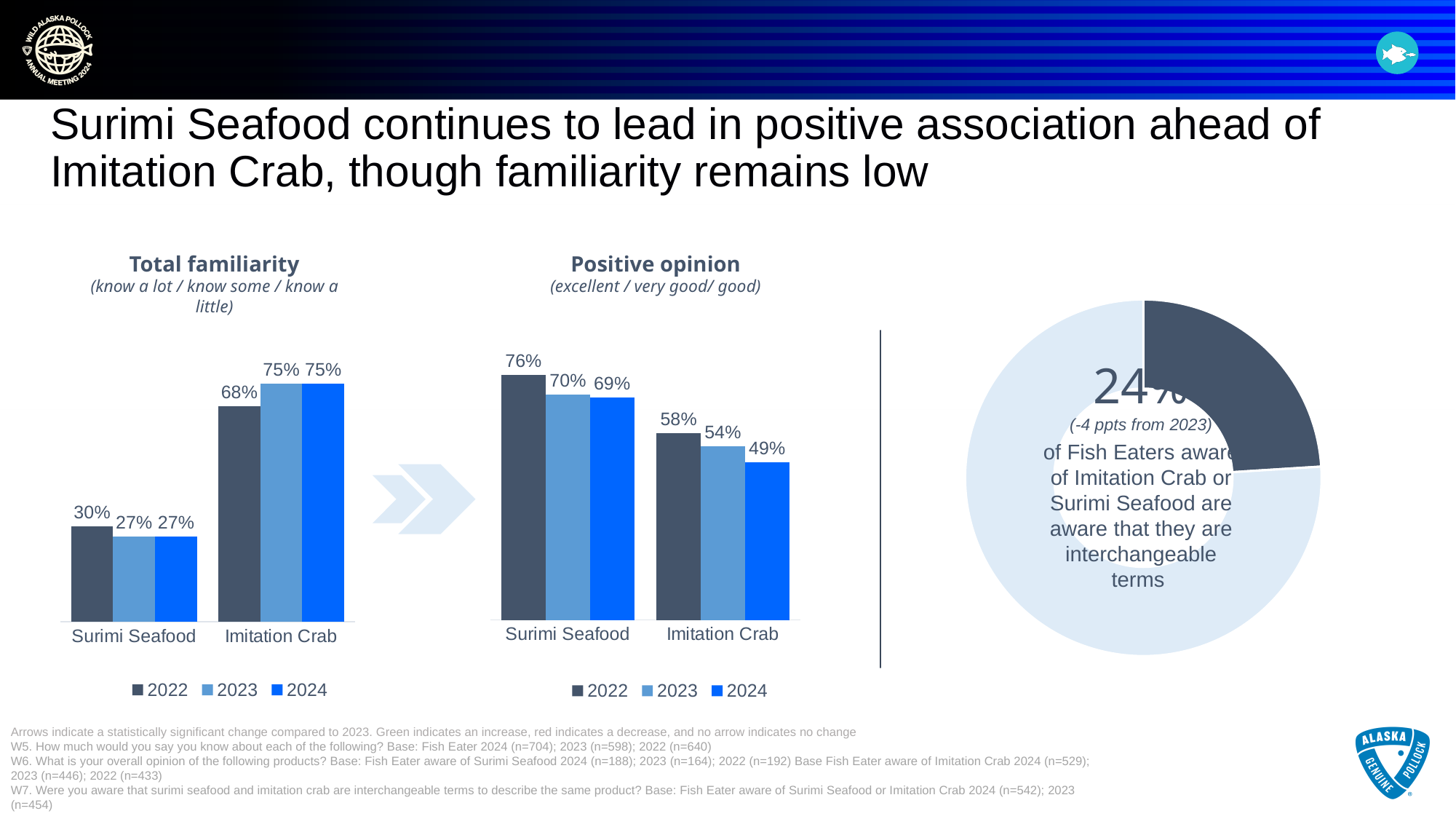
In the Positive opinion chart, which category has the highest 2024 value? Surimi Seafood In the Positive opinion chart, what is the 2022 value for Surimi Seafood? 76% How many series does the legend of the Total familiarity chart list? 3 In the Positive opinion chart, is the 2023 value for Surimi Seafood larger or smaller than the 2023 value for Imitation Crab? larger In the Positive opinion chart, what is the difference between the 2022 and 2024 values for Imitation Crab? 9% In the Total familiarity chart, what is the difference between the 2024 values for Imitation Crab and Surimi Seafood? 48% In the Positive opinion chart, do the values for Surimi Seafood rise or fall from 2022 to 2024? fall In the Total familiarity chart, what is the 2024 value for Surimi Seafood? 27% In the Total familiarity chart, what is the 2022 value for Imitation Crab? 68% In the Total familiarity chart, which category has the lowest 2023 value? Surimi Seafood In the Positive opinion chart, what is the 2024 value for Imitation Crab? 49% What kind of chart is the Positive opinion chart? bar chart